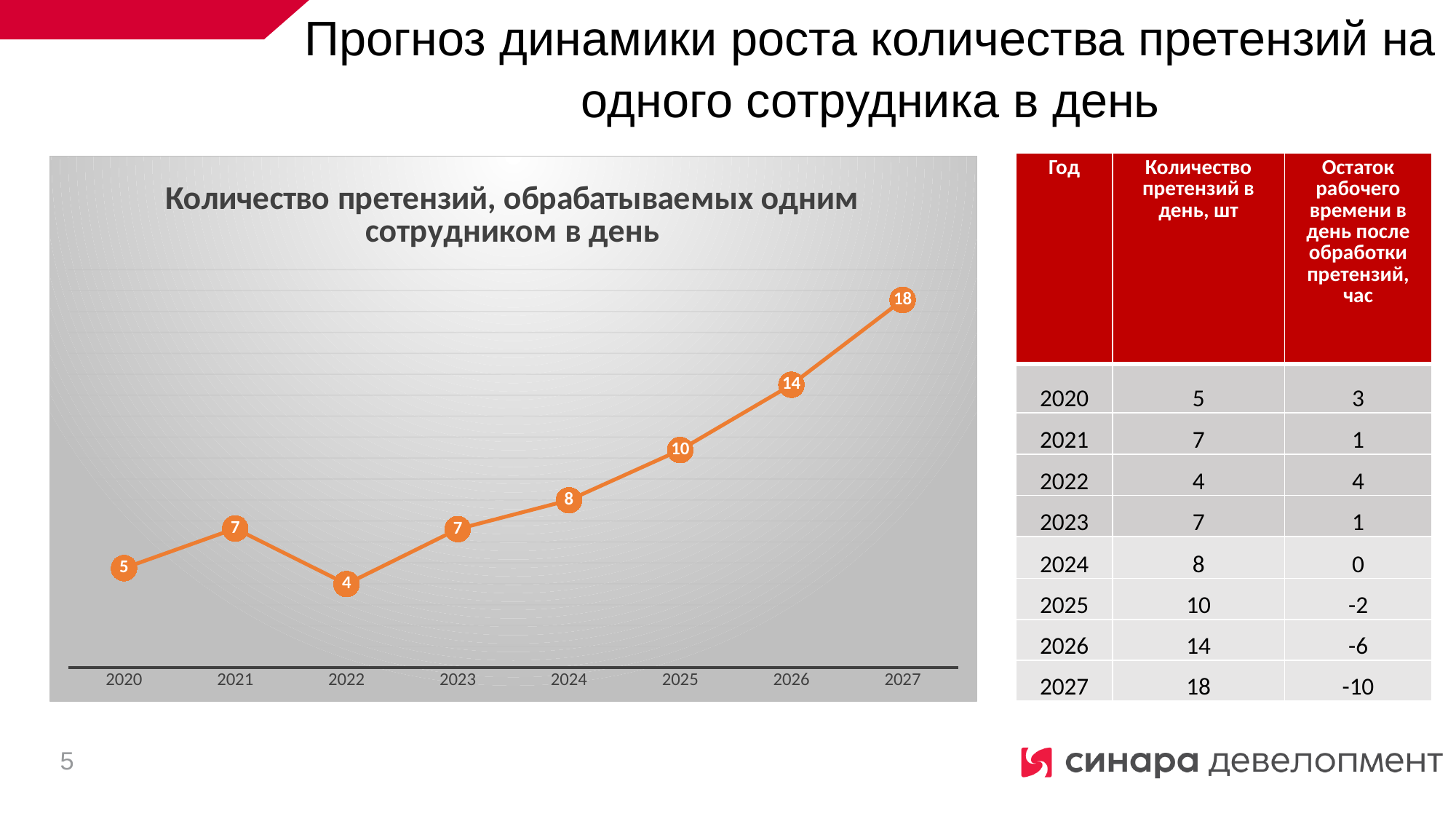
Which year has the lowest value in the chart? 2022 How many years are plotted on the x axis of the chart? 8 What is the difference between the values for 2021 and 2022? 3 Which is larger, the value for 2024 or the value for 2023? 2024 What kind of chart is shown on the slide? line chart What is the value for 2025 in the chart? 10 What is the value for 2027 in the chart? 18 What is the title of the chart? Количество претензий, обрабатываемых одним сотрудником в день What is the value for 2020 in the chart? 5 Which year has the highest value in the chart? 2027 Do the values rise or fall from 2023 to 2027? rise What is the difference between the values for 2027 and 2026? 4